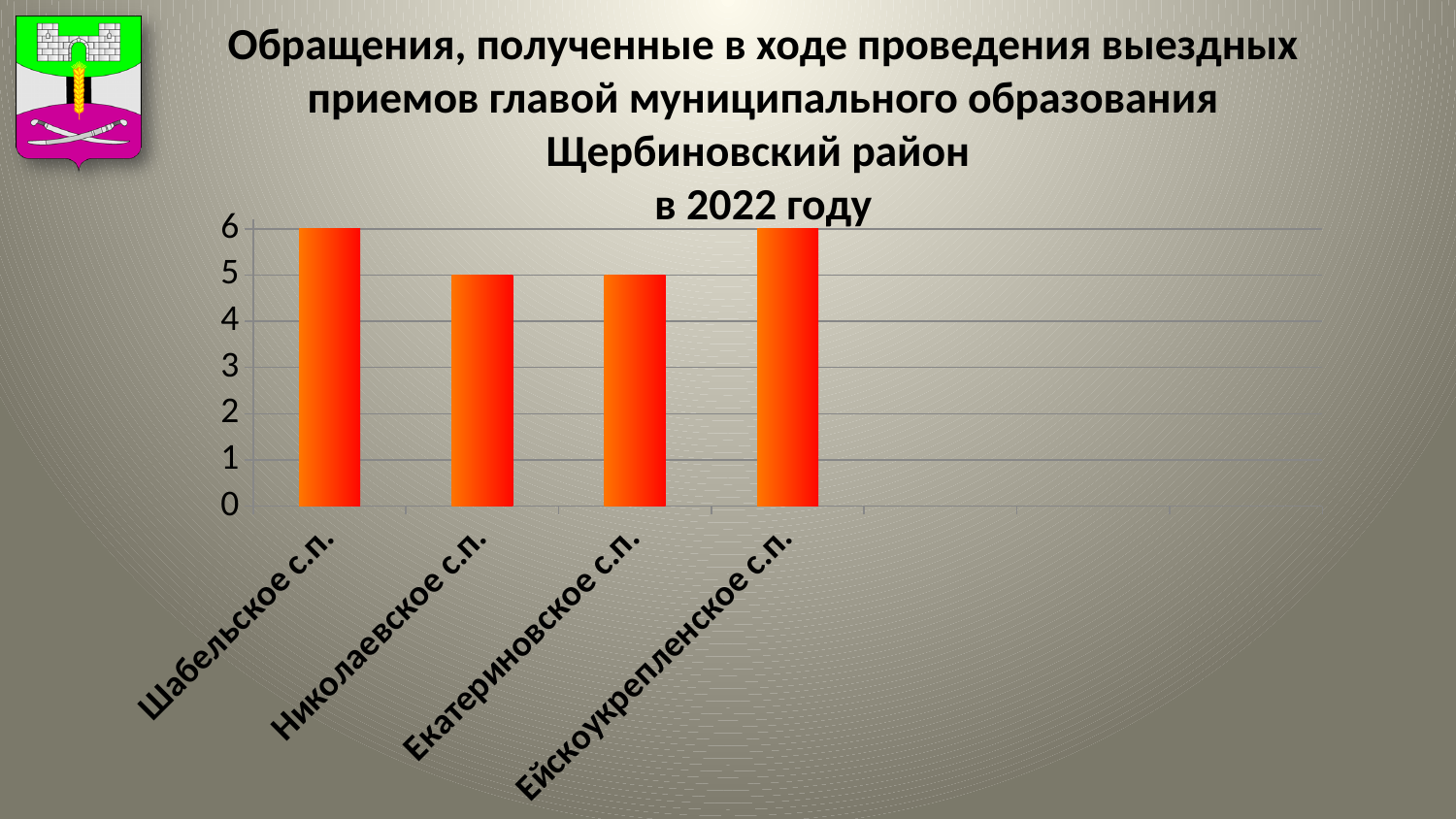
What is the difference between the values for Шабельское с.п. and Екатериновское с.п.? 1 How many categories are shown on the x axis? 4 What is the value for Ейскоукрепленское с.п.? 6 What kind of chart is shown on the slide? bar chart Is the value for Николаевское с.п. greater or less than 6? less What is the value for Шабельское с.п.? 6 What is the highest value shown on the vertical axis? 6 Which is larger, the value for Екатериновское с.п. or the value for Ейскоукрепленское с.п.? Ейскоукрепленское с.п. Which year does the chart title refer to? 2022 What is the value for Екатериновское с.п.? 5 What is the value for Николаевское с.п.? 5 Which is larger, the value for Шабельское с.п. or the value for Николаевское с.п.? Шабельское с.п.